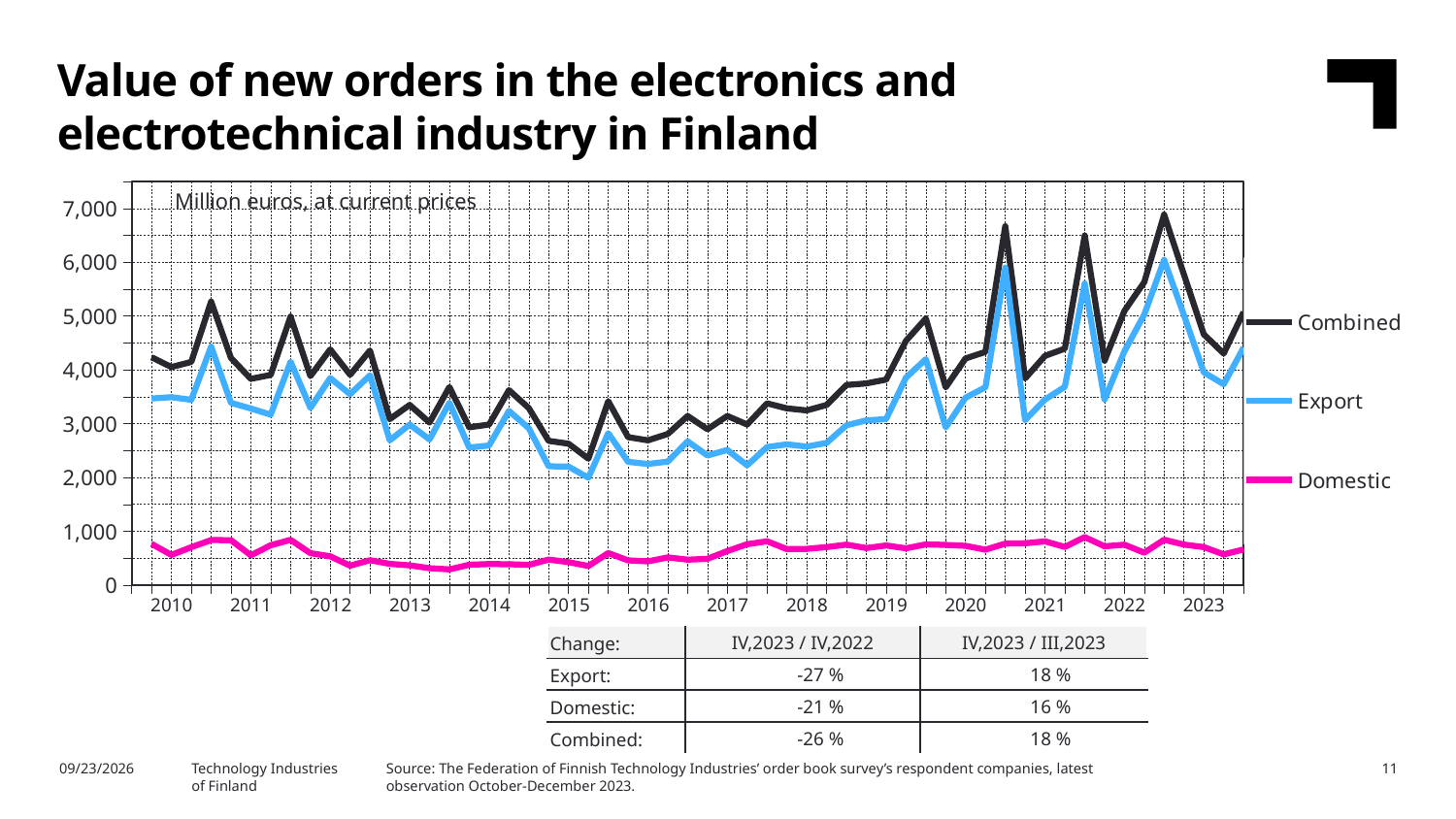
Is the Domestic value in 2015 greater or less than 1,000? less What unit is stated for the values in the chart? Million euros, at current prices Is the peak Combined value in 2022 greater or less than 6,000? greater How many series does the chart legend list? 3 What are the three series named in the chart legend? Combined, Export, Domestic According to the table below the chart, what is the Export change for IV,2023 / IV,2022? -27 % In 2020, which is larger, the Combined value or the Domestic value? Combined How many years are labeled on the x axis of the chart? 14 Which series has the lowest values throughout the chart? Domestic What type of chart is shown on the slide? Line chart Which series has the highest values throughout the chart? Combined Is the Export value in 2015 greater or less than 3,000? less